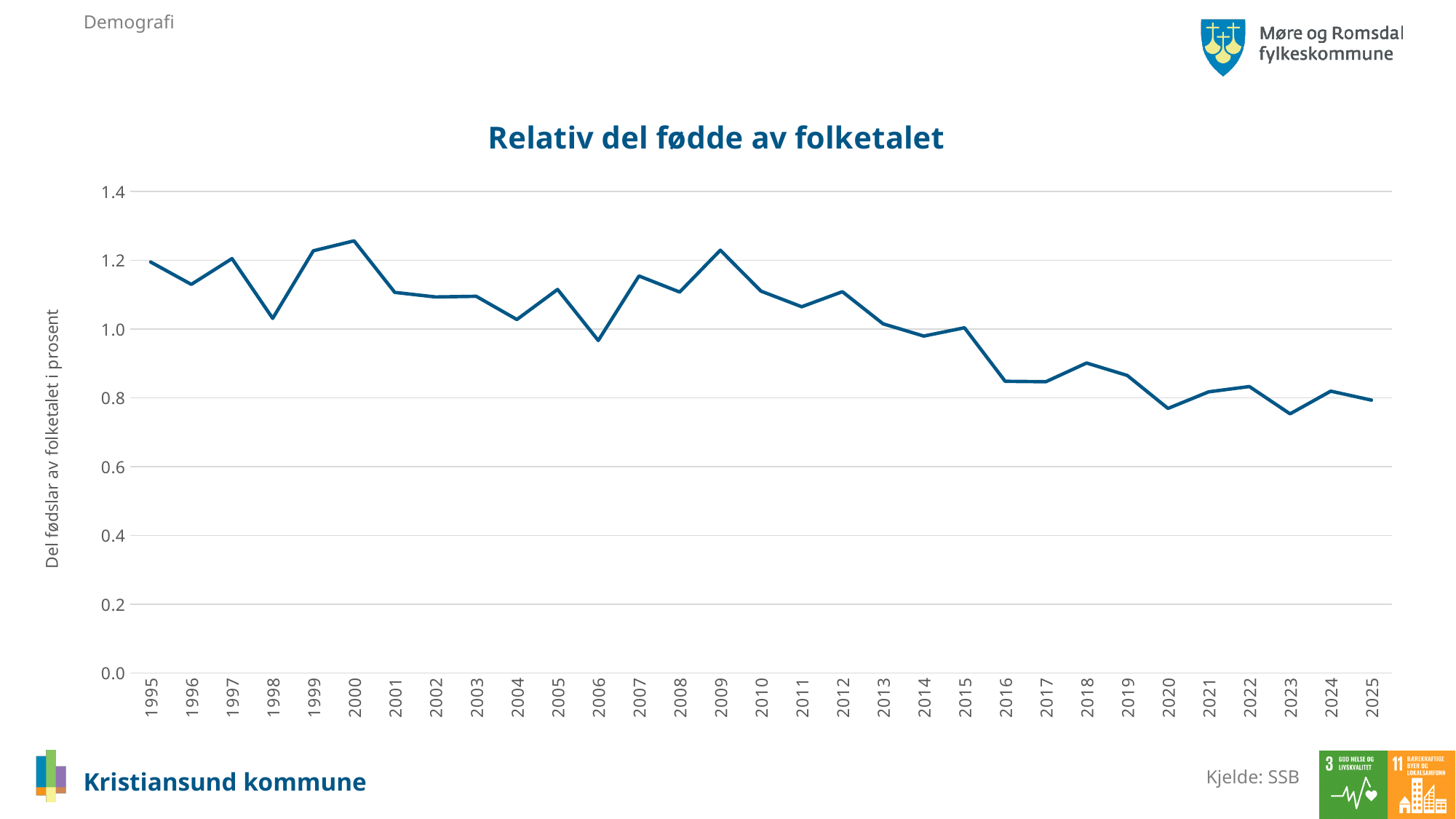
What is the title of the chart? Relativ del fødde av folketalet How many years are plotted along the x axis of the chart? 31 Is the value for 2000 greater or less than 1.2? greater Overall, do the values rise or fall from 1995 to 2025? fall Is the value for 2023 greater or less than 0.8? less What kind of chart is shown on the slide? line chart Which year has the larger value, 2018 or 2023? 2018 Is the value for 2016 greater or less than 0.8? greater What is the label on the vertical axis of the chart? Del fødslar av folketalet i prosent Which year has the larger value, 1995 or 2025? 1995